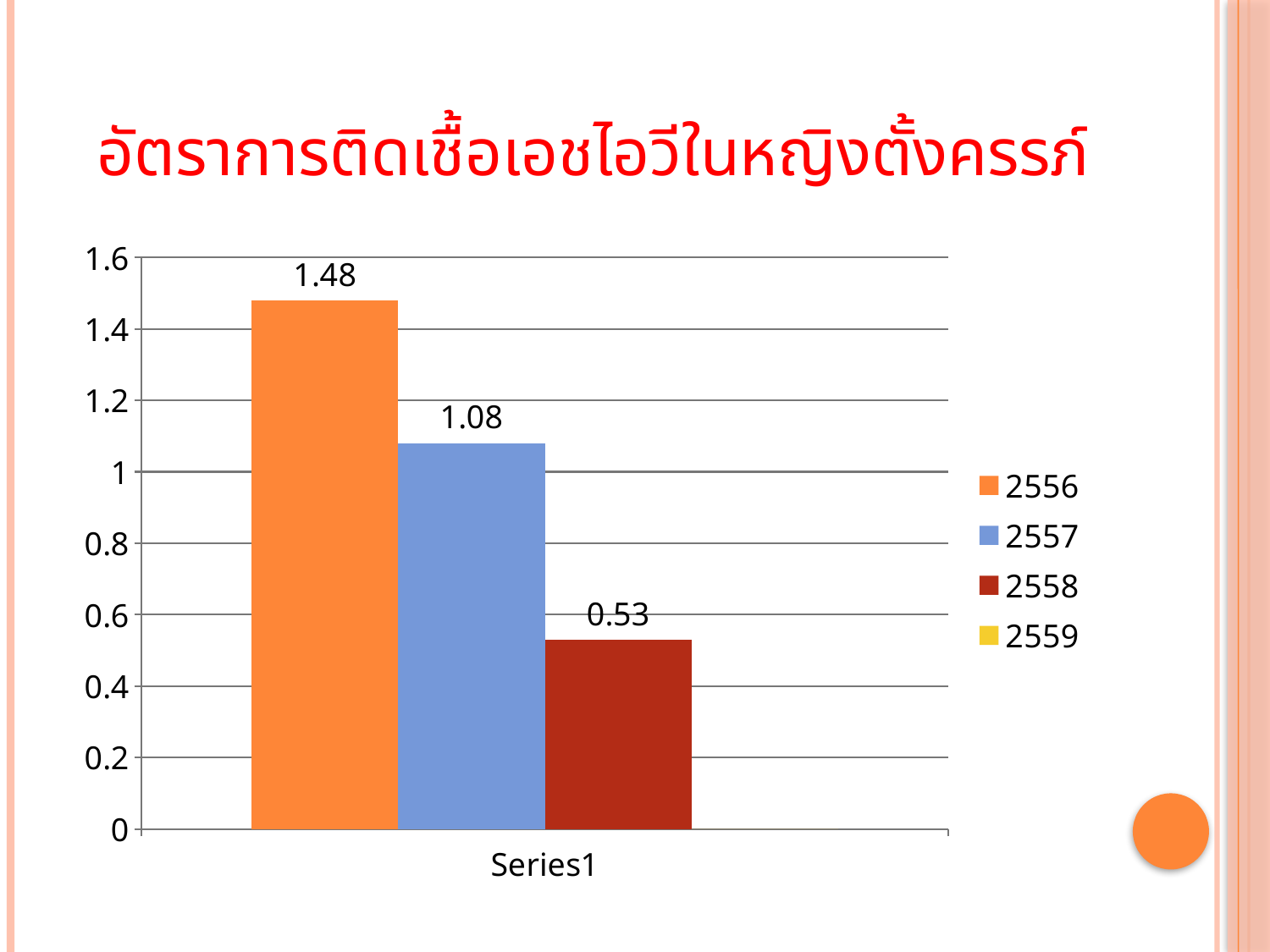
What is the value for 2557? 1.08 Is the value for 2556 greater or less than 1.4? greater What is the value for 2556? 1.48 What is the difference between the values for 2556 and 2557? 0.40 What kind of chart is shown? bar chart Which is larger, the value for 2557 or the value for 2558? 2557 Which plotted year has the lowest value? 2558 Do the values rise or fall from 2556 to 2558? fall Which year has the highest value? 2556 How many series does the legend list? 4 What is the difference between the values for 2557 and 2558? 0.55 What is the value for 2558? 0.53